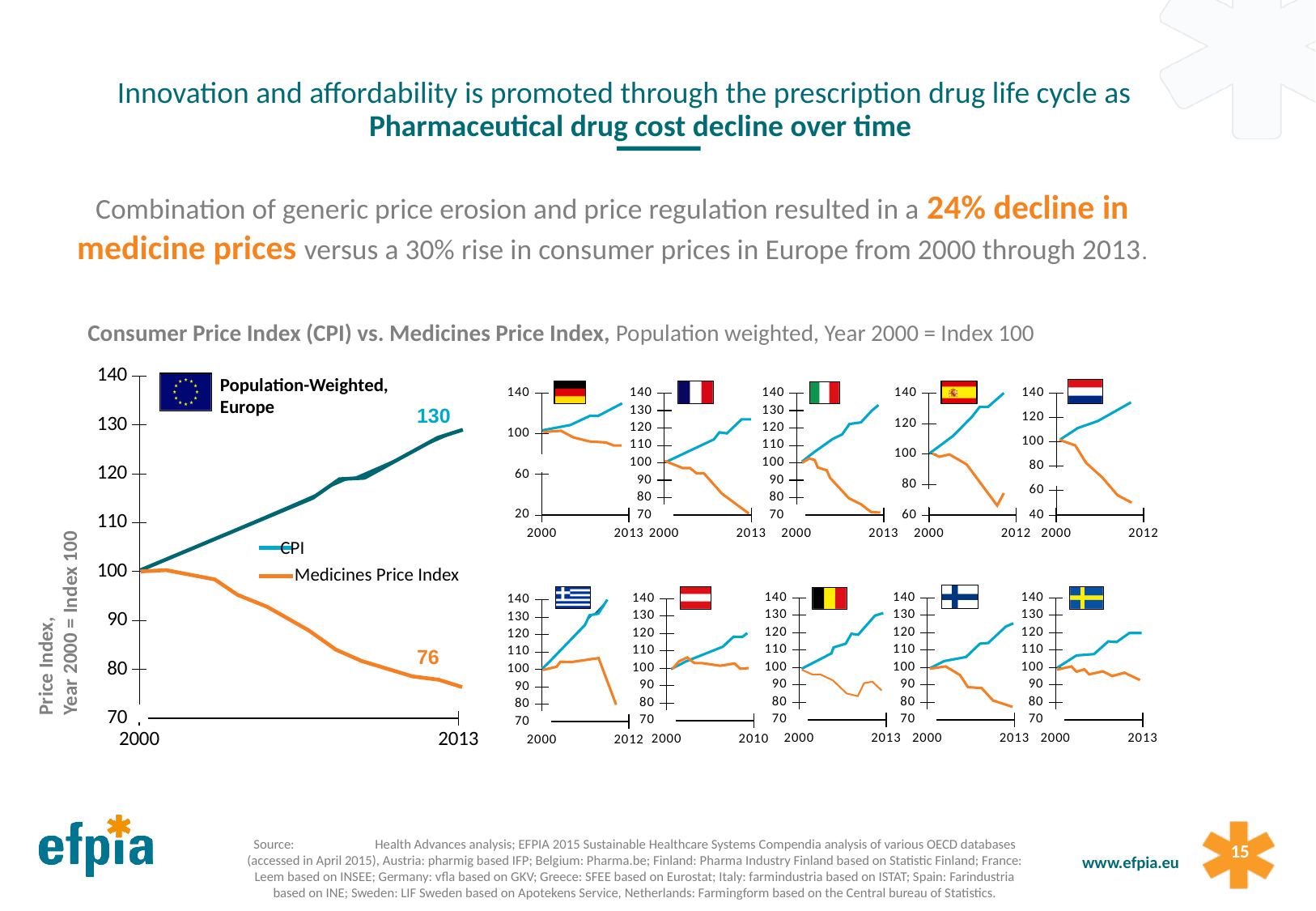
In the large Population-Weighted, Europe chart, does the CPI line rise or fall from 2000 to 2013? rise In the large Population-Weighted, Europe chart, which series ends higher in 2013, CPI or the Medicines Price Index? CPI In the large Population-Weighted, Europe chart, how many series does the legend list? 2 In the large Population-Weighted, Europe chart, what kind of chart is used to show CPI and the Medicines Price Index? line chart In the large Population-Weighted, Europe chart, what value does the CPI line reach at its end in 2013? 130 In the large Population-Weighted, Europe chart, which series is drawn in orange? Medicines Price Index In the large Population-Weighted, Europe chart, is the CPI value in 2013 greater or less than 120? greater In the large Population-Weighted, Europe chart, what value does the Medicines Price Index line reach at its end in 2013? 76 In the large Population-Weighted, Europe chart, what is the difference between the labelled end values of CPI (130) and the Medicines Price Index (76)? 54 In the large Population-Weighted, Europe chart, is the Medicines Price Index value in 2013 greater or less than 80? less In the large Population-Weighted, Europe chart, does the Medicines Price Index rise or fall from 2000 to 2013? fall How many small country charts are shown to the right of the large Population-Weighted, Europe chart? 10